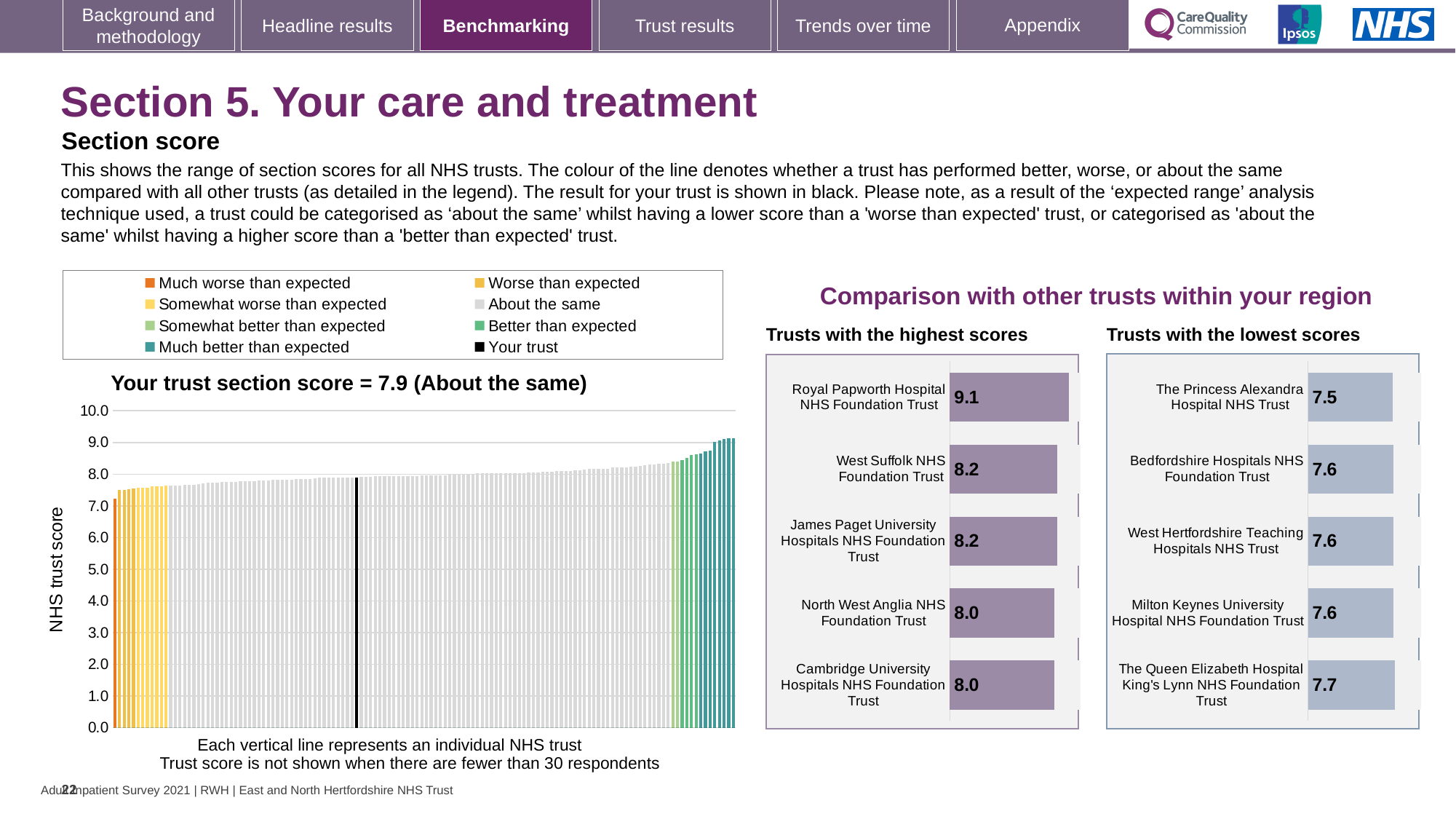
In the 'Trusts with the highest scores' chart, what is the difference between the scores of Royal Papworth Hospital NHS Foundation Trust and Cambridge University Hospitals NHS Foundation Trust? 1.1 How many trusts are shown in the 'Trusts with the lowest scores' chart? 5 In the 'Trusts with the highest scores' chart, which trust has the highest score? Royal Papworth Hospital NHS Foundation Trust In the 'Trusts with the lowest scores' chart, what is the difference between the scores of The Queen Elizabeth Hospital King's Lynn NHS Foundation Trust and The Princess Alexandra Hospital NHS Trust? 0.2 What kind of chart is the main chart on the left showing the range of section scores? Bar chart In the 'Trusts with the lowest scores' chart, which trust has the lowest score? The Princess Alexandra Hospital NHS Trust What is the y-axis label of the main chart on the left? NHS trust score In the main chart on the left, what is your trust's section score? 7.9 How many entries does the legend above the main chart on the left list? 8 In the 'Trusts with the highest scores' chart, which has the higher score: West Suffolk NHS Foundation Trust or North West Anglia NHS Foundation Trust? West Suffolk NHS Foundation Trust In the 'Trusts with the lowest scores' chart, what is the score for The Princess Alexandra Hospital NHS Trust? 7.5 In the 'Trusts with the highest scores' chart, what is the score for Royal Papworth Hospital NHS Foundation Trust? 9.1